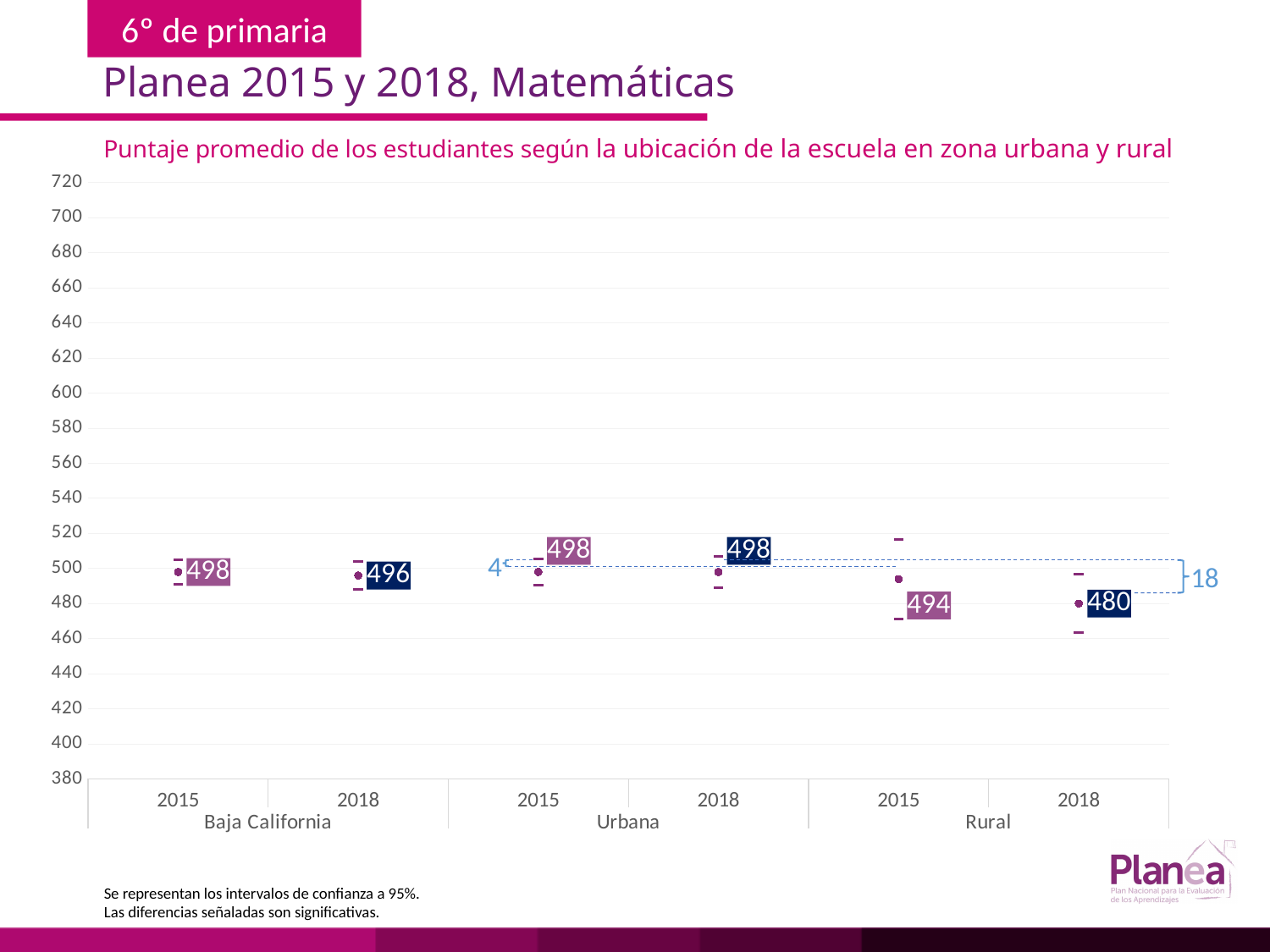
What is the average score for Baja California in 2015? 498 Which group and year has the lowest average score? Rural 2018 Did the Rural average score rise or fall from 2015 to 2018? fall What is the difference between the Rural scores in 2015 and 2018? 14 How many data points are plotted on the chart? 6 What is the average score for Baja California in 2018? 496 What is the difference between the Urbana and Rural scores in 2018? 18 What is the average score for Rural schools in 2018? 480 What is the average score for Rural schools in 2015? 494 Which is larger, the Rural score in 2015 or the Rural score in 2018? Rural 2015 Is the value for Rural 2018 greater or less than 500? less What is the average score for Urbana schools in 2018? 498